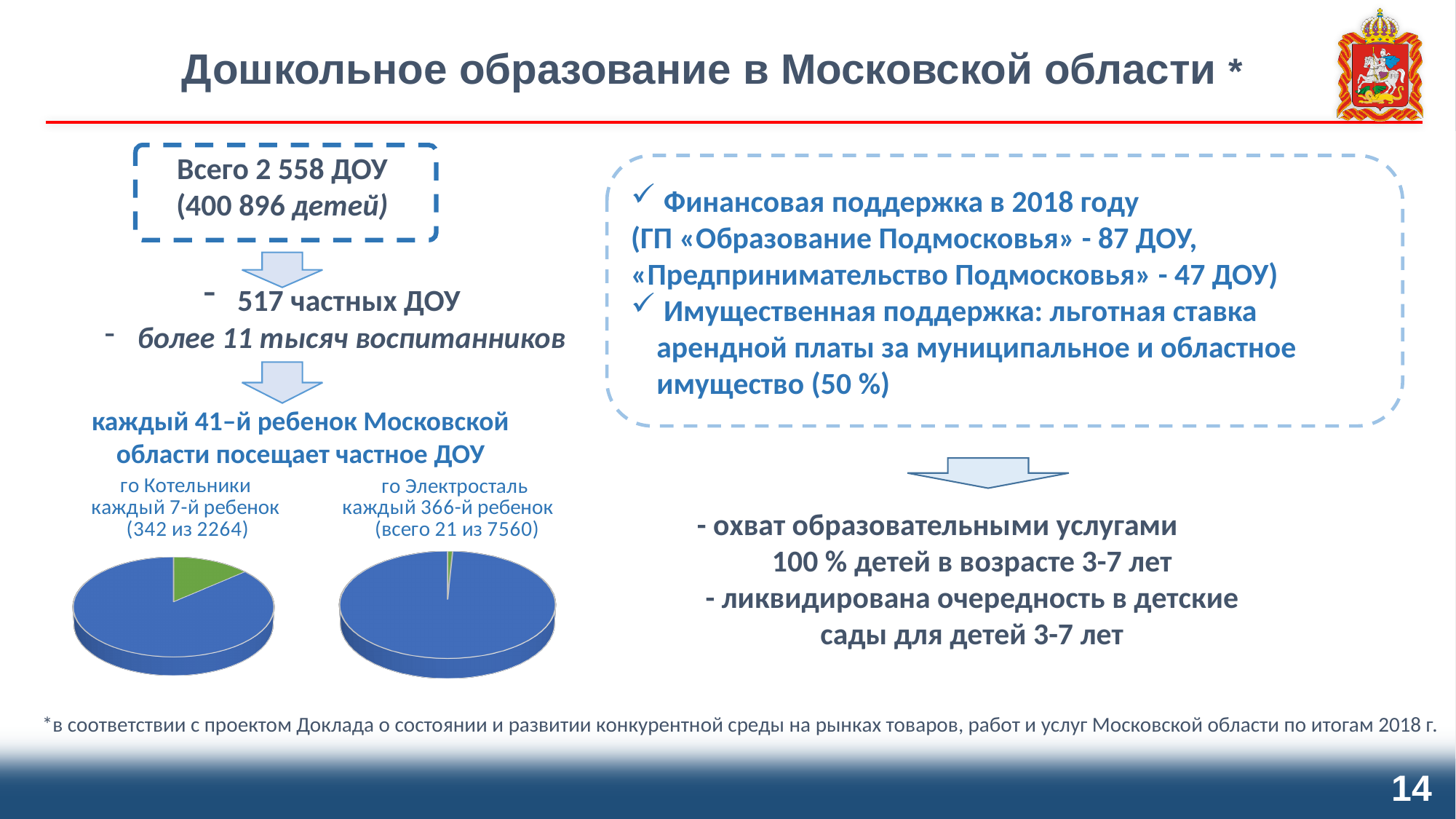
How many slices does the го Котельники pie chart have? 2 In the го Котельники pie chart, which slice is larger, the blue one or the green one? the blue one What kind of chart is used for го Электросталь? pie chart According to the caption of the го Котельники pie chart, every which child attends a private ДОУ? каждый 7-й ребенок Which pie chart has the larger green slice, го Котельники or го Электросталь? го Котельники According to the caption of the го Электросталь pie chart, how many children out of 7560 are represented by the small slice? 21 What colour is the large slice in both pie charts? blue In the го Электросталь pie chart, which slice is smaller, the blue one or the green one? the green one According to the caption of the го Электросталь pie chart, every which child attends a private ДОУ? каждый 366-й ребенок What kind of chart is used for го Котельники? pie chart According to the caption of the го Котельники pie chart, how many children out of 2264 are represented by the small slice? 342 How many slices does the го Электросталь pie chart have? 2